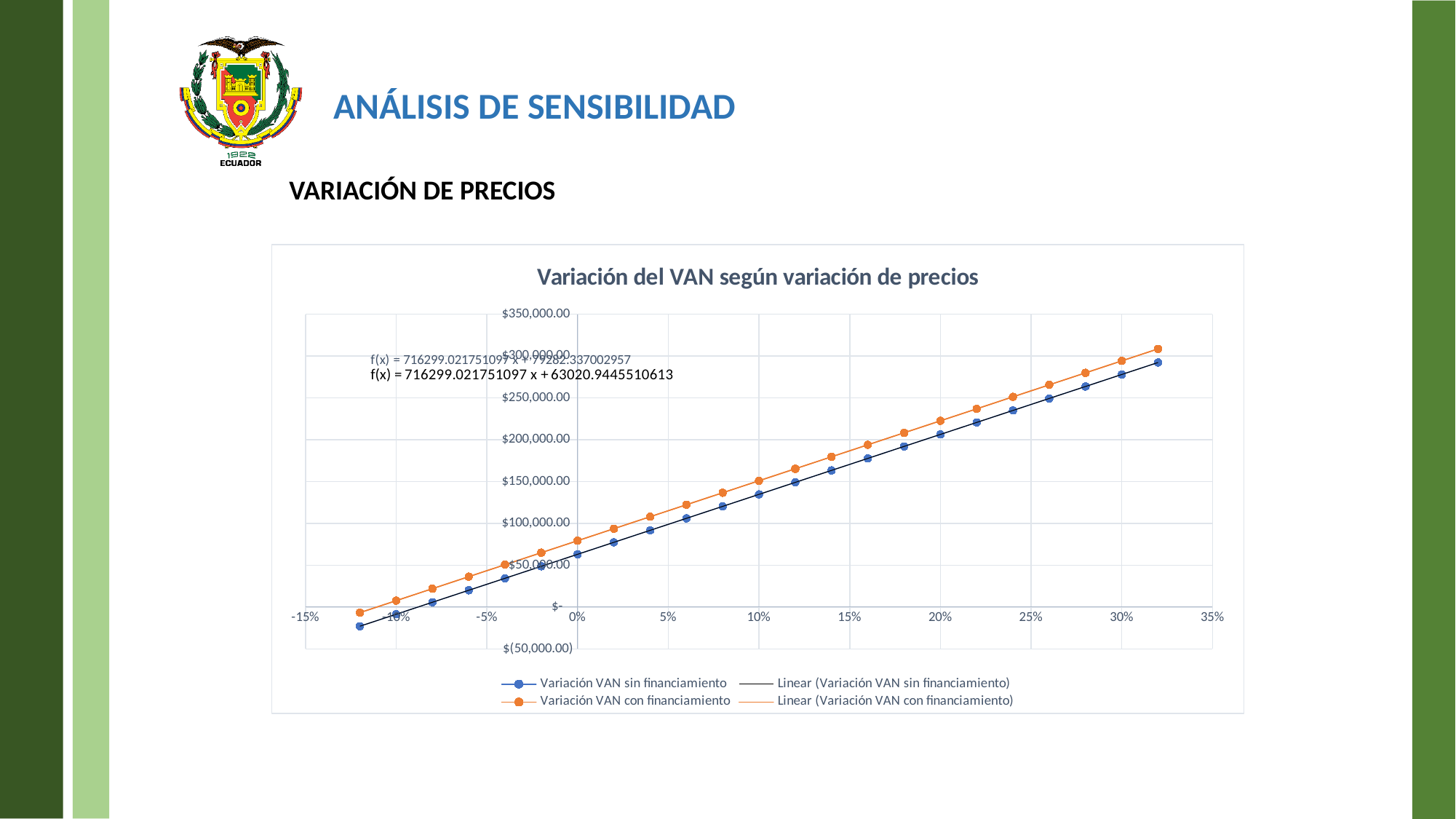
Is the value of 'Variación VAN con financiamiento' at 20% price variation greater or less than $200,000.00? greater Is the value of 'Variación VAN sin financiamiento' at 0% price variation greater or less than $50,000.00? greater Is the value of 'Variación VAN sin financiamiento' at 30% price variation greater or less than $250,000.00? greater How many entries does the chart legend list? 4 Do the values of 'Variación VAN con financiamiento' rise or fall as the price variation increases along the x axis? rise What kind of chart is shown on the slide? line chart What is the slope coefficient shown in the trendline equation f(x) = ... x + 63020.9445510613? 716299.021751097 What is the title of the chart? Variación del VAN según variación de precios At a price variation of 20%, which series has the larger value: 'Variación VAN con financiamiento' or 'Variación VAN sin financiamiento'? Variación VAN con financiamiento Do the values of 'Variación VAN sin financiamiento' rise or fall as the price variation increases along the x axis? rise